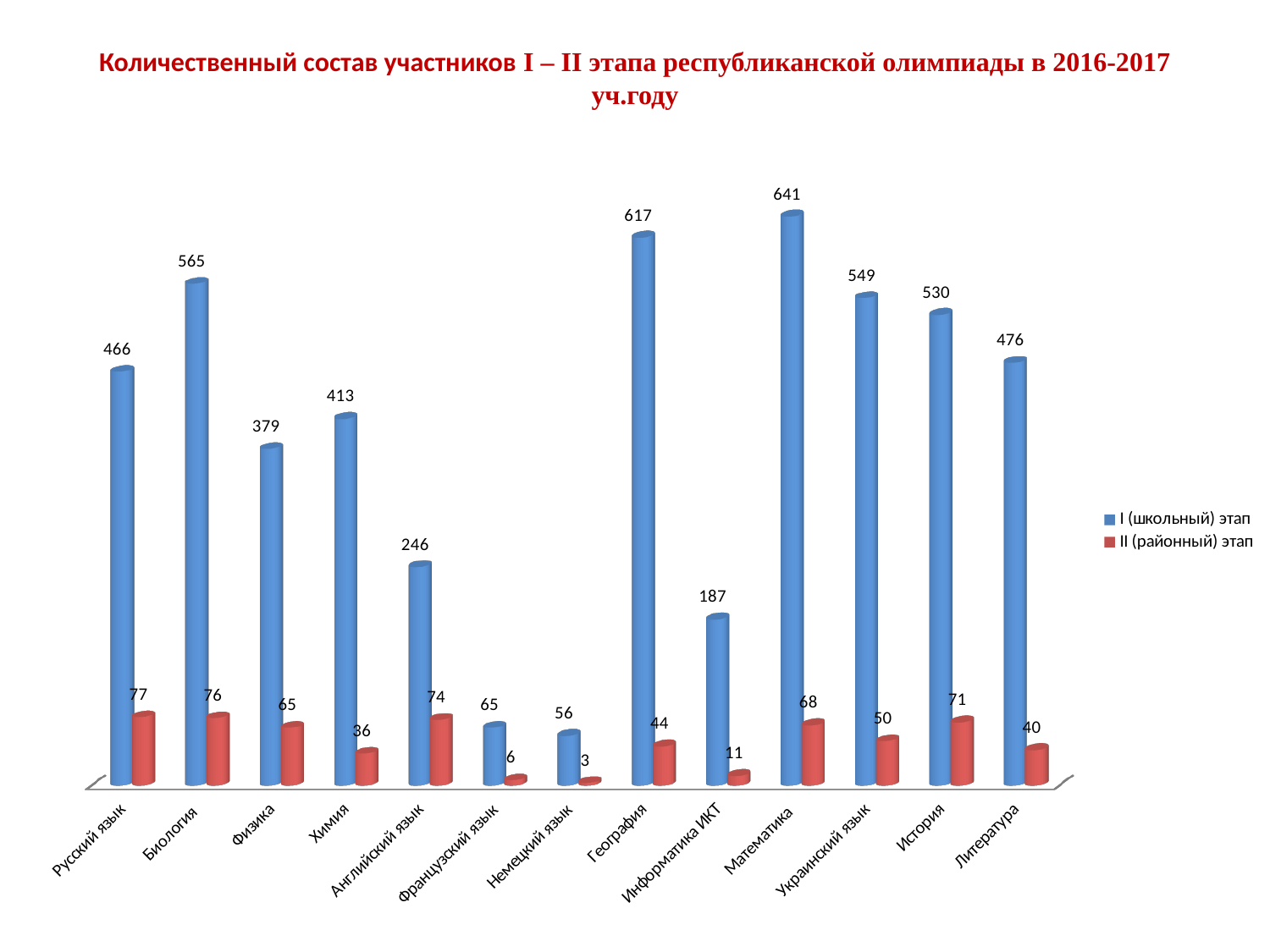
Which category has the lowest value in the II (районный) этап series? Немецкий язык What is the difference between the I (школьный) этап values for Биология and Русский язык? 99 How many categories are shown on the x axis? 13 What is the value for Математика in the I (школьный) этап series? 641 What is the difference between the I (школьный) этап and II (районный) этап values for География? 573 How many series does the legend list? 2 What is the value for Английский язык in the II (районный) этап series? 74 Which category has the highest value in the I (школьный) этап series? Математика Which category has the lowest value in the I (школьный) этап series? Немецкий язык What kind of chart is shown on the slide? Bar chart What is the value for Информатика ИКТ in the I (школьный) этап series? 187 Which is larger: the I (школьный) этап value for Украинский язык or for История? Украинский язык